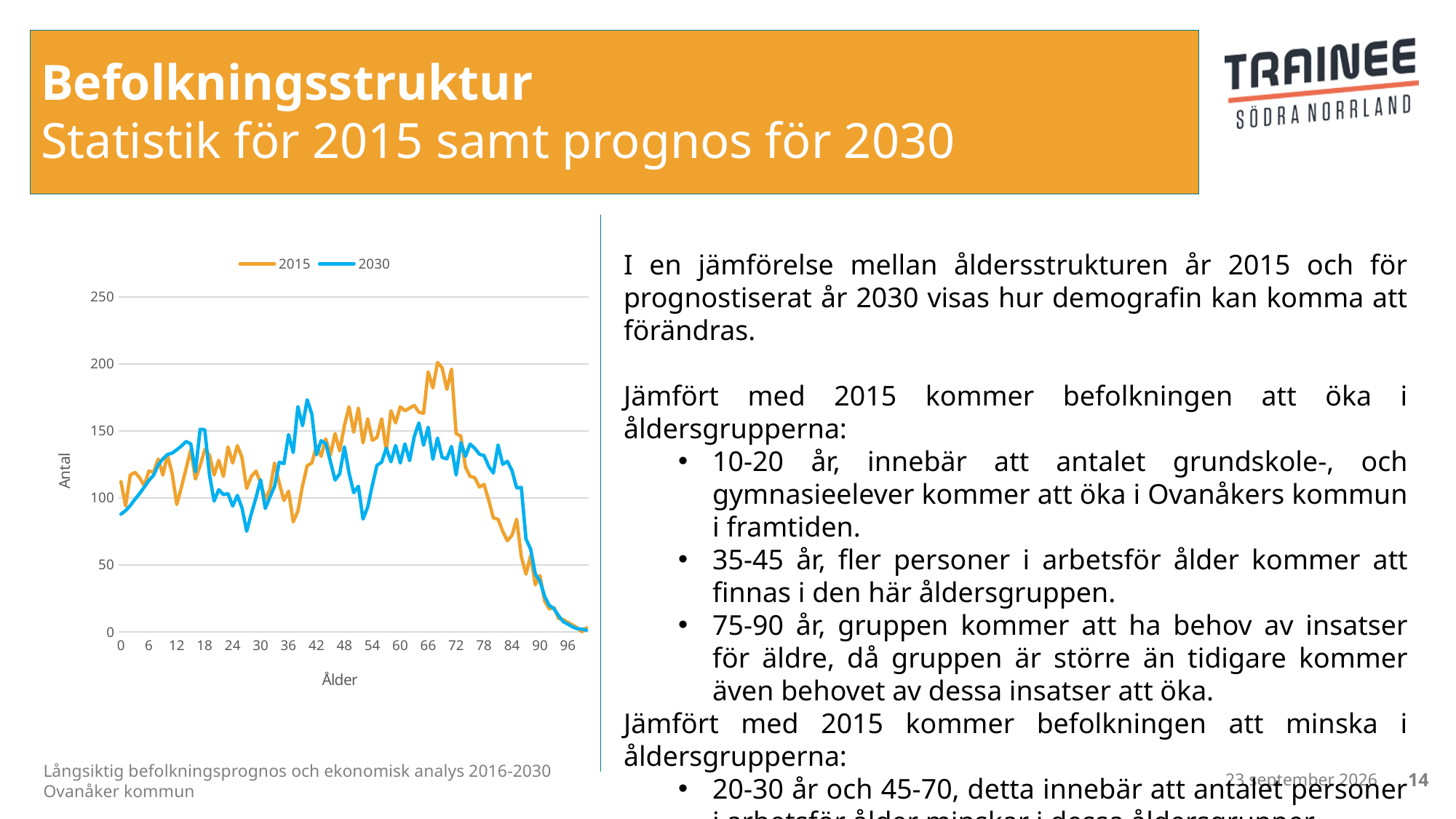
How many series does the chart legend list? 2 What is the title of the chart's horizontal axis? Ålder What are the two series named in the chart legend? 2015 and 2030 Is the value of the 2030 series at age 40 greater or less than 150? greater Which series reaches the highest value anywhere on the chart? 2015 At age 72, which series has the larger value, 2015 or 2030? 2015 Is the value of the 2015 series at age 96 greater or less than 50? less What kind of chart is shown on the slide? line chart Do the values of both series rise or fall along the x axis from age 72 to age 96? fall At age 40, which series has the larger value, 2015 or 2030? 2030 Is the value of the 2015 series at age 0 greater or less than 100? greater